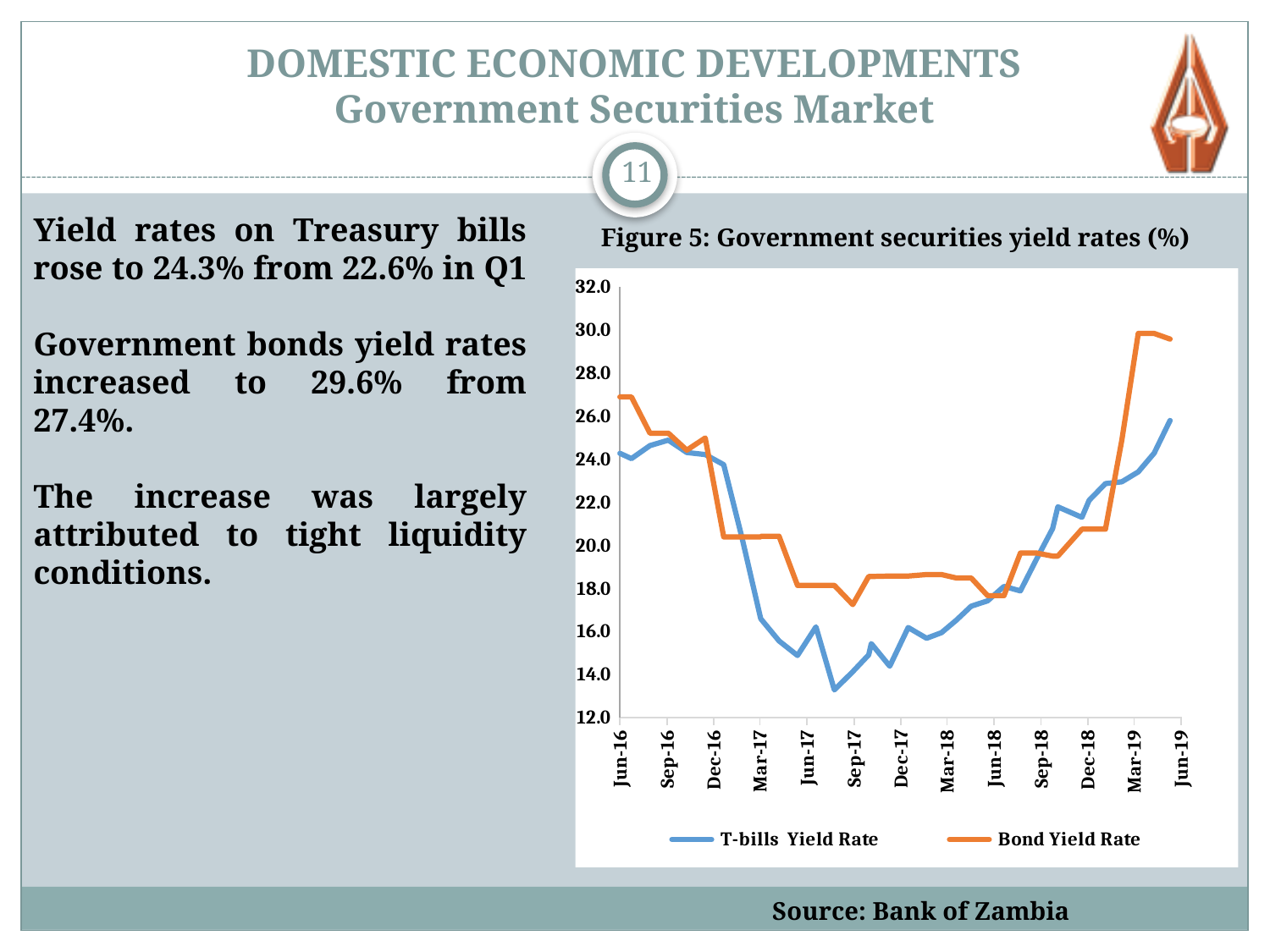
What is the title of the chart on the slide? Figure 5: Government securities yield rates (%) Does the Bond Yield Rate rise or fall between Jun-18 and Jun-19? Rise What kind of chart is Figure 5? Line chart Is the Bond Yield Rate at Jun-17 greater or less than 20.0? less Is the T-bills Yield Rate at Sep-17 greater or less than 16.0? less Is the Bond Yield Rate at Jun-19 greater or less than 28.0? greater At Jun-19, which series has the higher value, T-bills Yield Rate or Bond Yield Rate? Bond Yield Rate How many date labels are shown on the x axis of Figure 5? 13 At Mar-17, which series has the higher value, T-bills Yield Rate or Bond Yield Rate? Bond Yield Rate How many series does the legend of Figure 5 list? 2 What are the two series named in the legend of Figure 5? T-bills Yield Rate and Bond Yield Rate